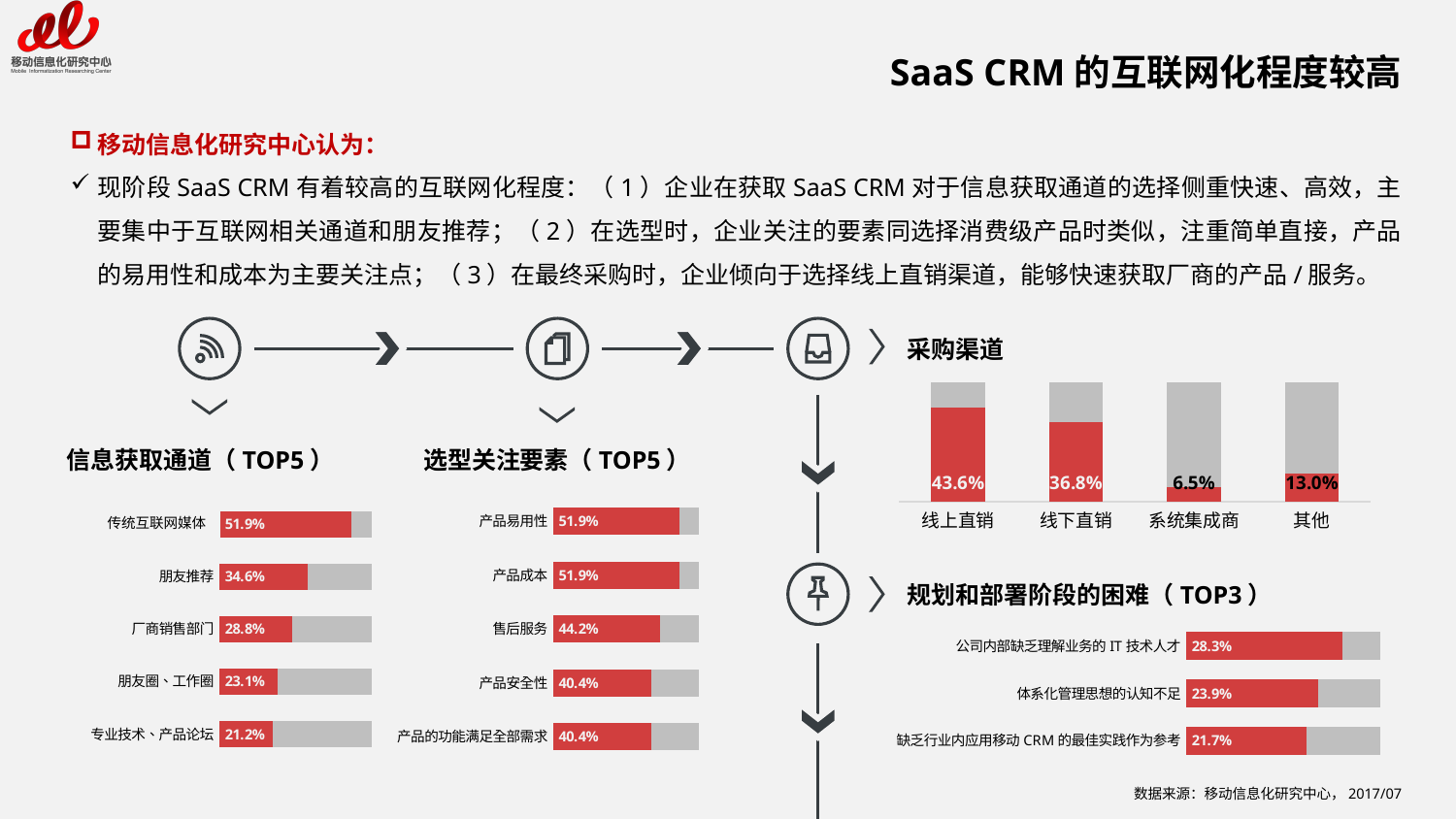
In the 信息获取通道（TOP5） chart, what is the value for 传统互联网媒体? 51.9% In the 规划和部署阶段的困难（TOP3） chart, what is the value for 体系化管理思想的认知不足? 23.9% What kind of chart is the 采购渠道 chart? bar chart In the 选型关注要素（TOP5） chart, which is larger, 产品成本 or 产品安全性? 产品成本 In the 采购渠道 chart, which category has the highest value? 线上直销 In the 选型关注要素（TOP5） chart, how many categories are shown? 5 In the 采购渠道 chart, what is the difference between 其他 and 系统集成商? 6.5% In the 信息获取通道（TOP5） chart, what is the difference between 朋友推荐 and 厂商销售部门? 5.8% In the 信息获取通道（TOP5） chart, which category has the lowest value? 专业技术、产品论坛 In the 规划和部署阶段的困难（TOP3） chart, which category has the highest value? 公司内部缺乏理解业务的 IT 技术人才 In the 采购渠道 chart, what is the value for 线上直销? 43.6% In the 选型关注要素（TOP5） chart, what is the value for 售后服务? 44.2%